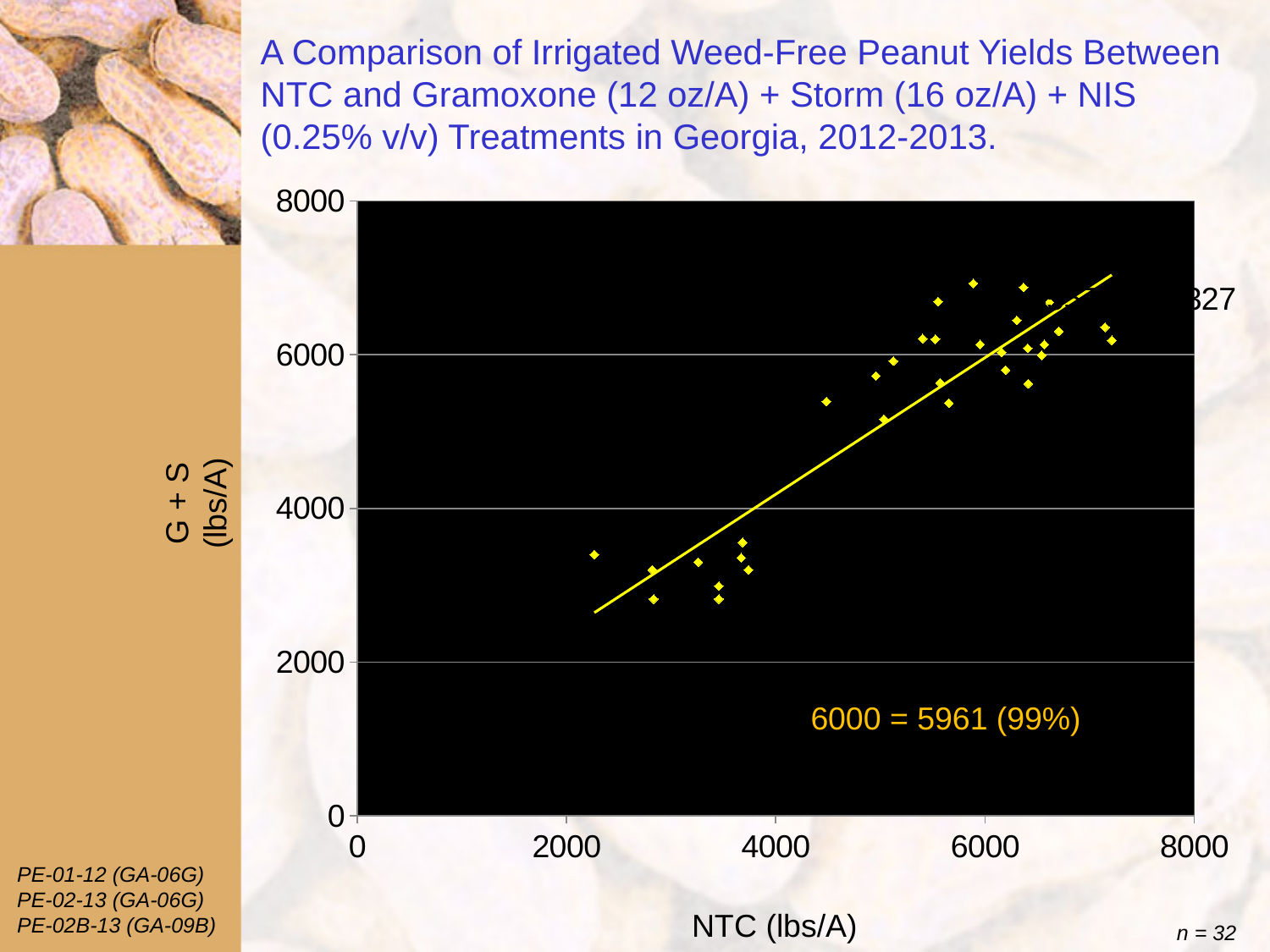
Is the lowest plotted G + S value greater or less than 4000? less How many data points are plotted, according to the n value shown on the slide? 32 What is the maximum value shown on the x axis? 8000 What percentage is shown in the annotation '6000 = 5961'? 99% What kind of chart is shown on the slide? Scatter plot What is the maximum value shown on the y axis? 8000 What is the label of the x axis? NTC (lbs/A) Is the highest plotted G + S value greater or less than 6000? greater Are the plotted points with NTC values below 4000 above or below 4000 on the G + S axis? below Do the G + S values rise or fall as NTC increases along the x axis? Rise What is the label of the y axis? G + S (lbs/A) According to the annotation on the chart, what G + S value corresponds to an NTC value of 6000? 5961